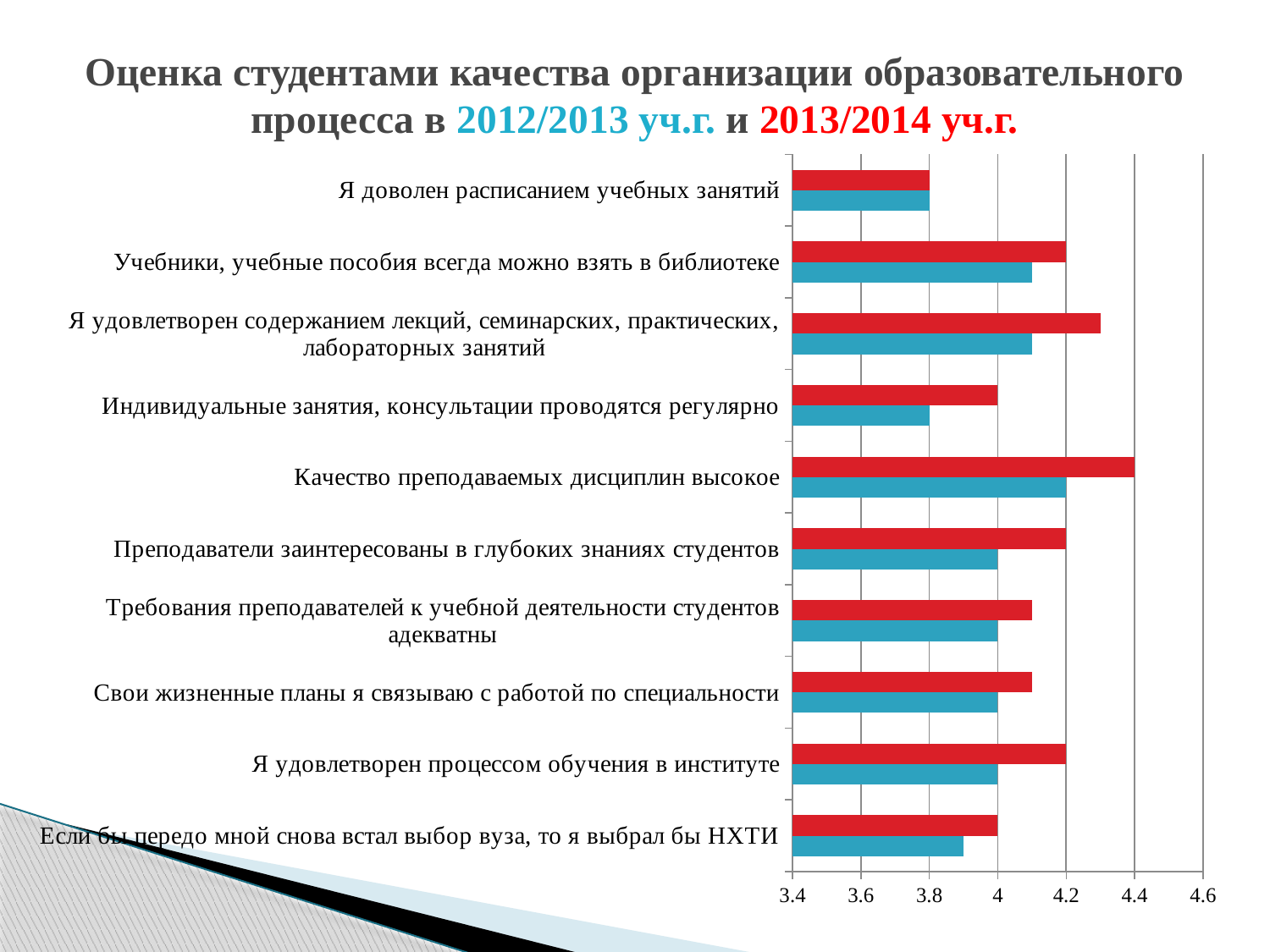
Is the blue (2012/2013) value for 'Если бы передо мной снова встал выбор вуза, то я выбрал бы НХТИ' greater or less than 4? less Is the blue (2012/2013) value for 'Учебники, учебные пособия всегда можно взять в библиотеке' greater or less than 4? greater How many data series does the chart show? 2 Which academic year is shown in red in the slide title? 2013/2014 уч.г. How many categories (statements) are plotted in the chart? 10 What is the red (2013/2014) value for 'Качество преподаваемых дисциплин высокое'? 4.4 What kind of chart is shown on the slide? bar chart What is the blue (2012/2013) value for 'Качество преподаваемых дисциплин высокое'? 4.2 For 'Преподаватели заинтересованы в глубоких знаниях студентов', which bar is larger, the red (2013/2014) or the blue (2012/2013)? red (2013/2014) What is the red (2013/2014) value for 'Я доволен расписанием учебных занятий'? 3.8 Which statement has the highest value among the red (2013/2014) bars? Качество преподаваемых дисциплин высокое What is the difference between the red and blue bars for 'Качество преподаваемых дисциплин высокое'? 0.2